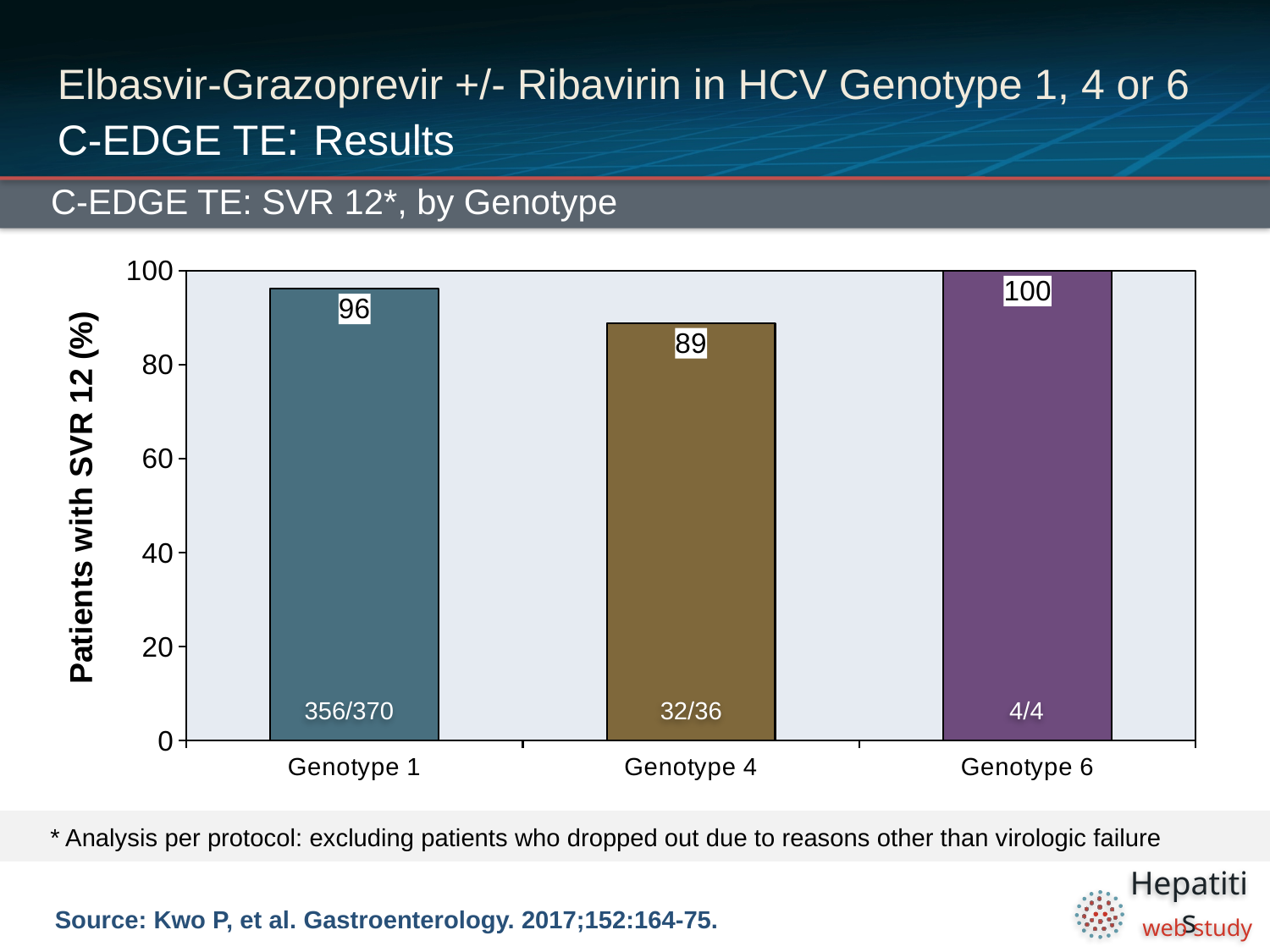
What fraction of patients is shown inside the Genotype 4 bar? 32/36 How many genotype categories are shown in the chart? 3 Which genotype has the lowest SVR 12 rate? Genotype 4 Which genotype has the highest SVR 12 rate? Genotype 6 What is the SVR 12 rate for Genotype 4? 89 What is the difference in SVR 12 rate between Genotype 1 and Genotype 4? 7 What is the title of the chart? C-EDGE TE: SVR 12*, by Genotype What is the SVR 12 rate for Genotype 6? 100 What type of chart is shown on the slide? Bar chart Which has a higher SVR 12 rate, Genotype 1 or Genotype 4? Genotype 1 What fraction of patients is shown inside the Genotype 1 bar? 356/370 What is the SVR 12 rate for Genotype 1? 96